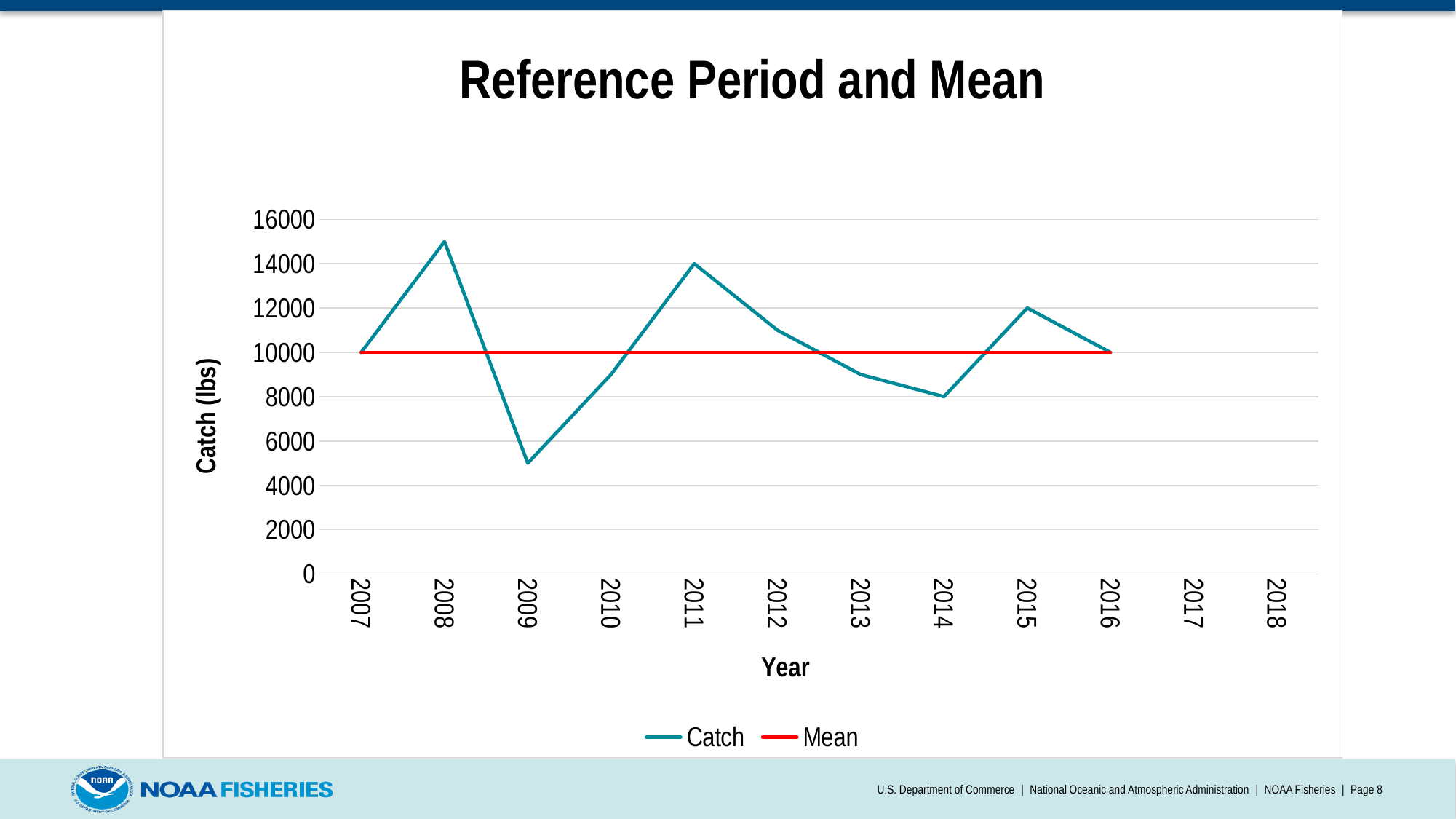
What is the Catch value for 2011? 14000 Does the Catch line rise or fall from 2011 to 2014? Fall Which year has the highest Catch value? 2008 What is the difference between the Catch values for 2011 and 2014? 6000 How many series does the legend list? 2 What is the value of the Mean line? 10000 What is the Catch value for 2014? 8000 Is the Catch value for 2009 greater or less than 6000? less Which year has the larger Catch value, 2011 or 2015? 2011 Is the Catch value for 2008 greater or less than 14000? greater Which year has the lowest Catch value? 2009 What type of chart is shown on the slide? Line chart